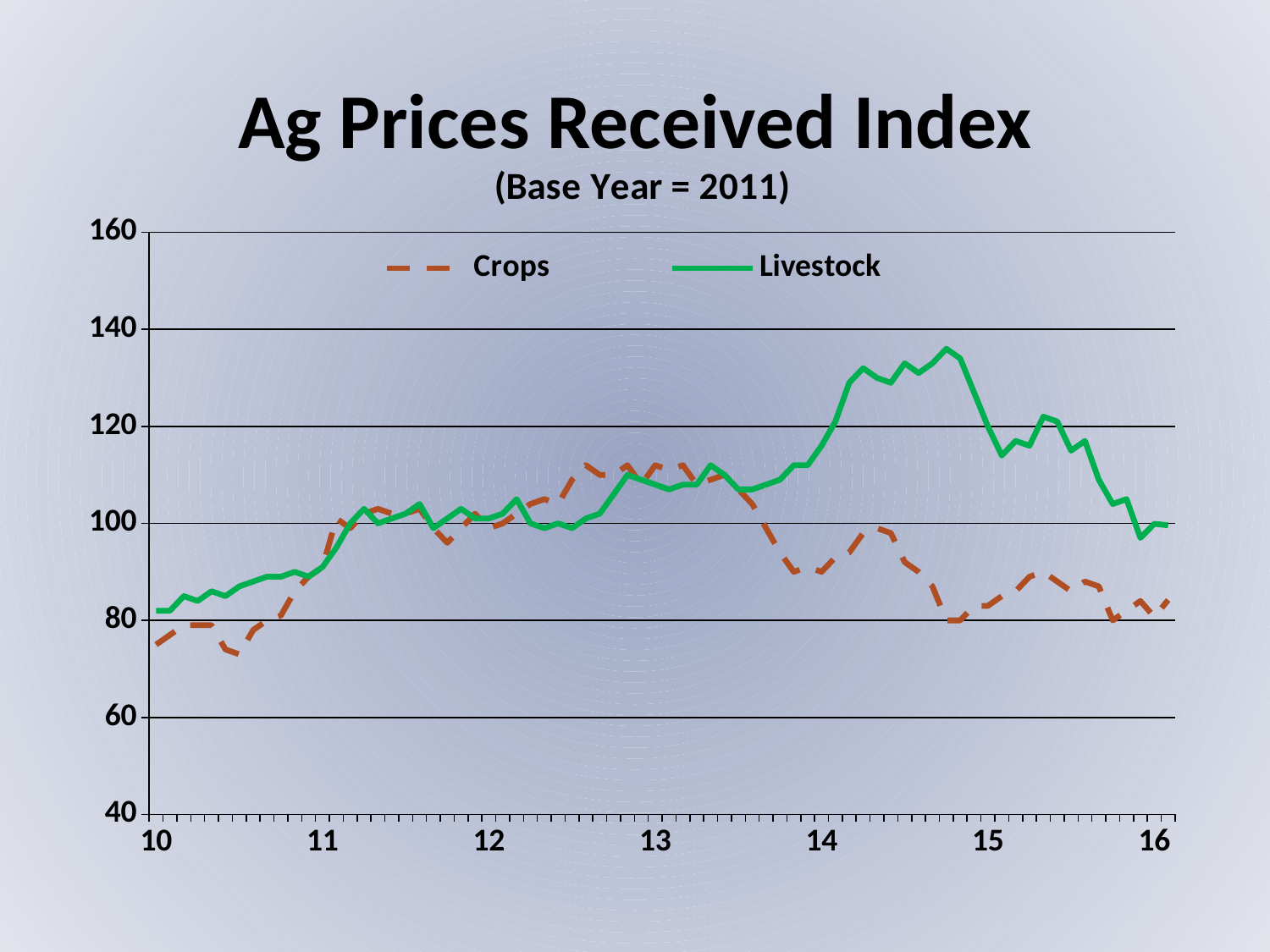
Which series is drawn with a dashed line? Crops Is the Livestock value at 10 greater or less than 100? less Which series reaches the highest value on the chart? Livestock Is the Crops value at 15 greater or less than 100? less What kind of chart is shown on the slide? line chart At 16, which series has the higher value, Crops or Livestock? Livestock Does the Livestock series rise or fall between 15 and 16? fall What is the title of the chart? Ag Prices Received Index At 15, which series has the higher value, Crops or Livestock? Livestock Is the Livestock value at its peak near 14.75 greater or less than 120? greater How many series does the legend list? 2